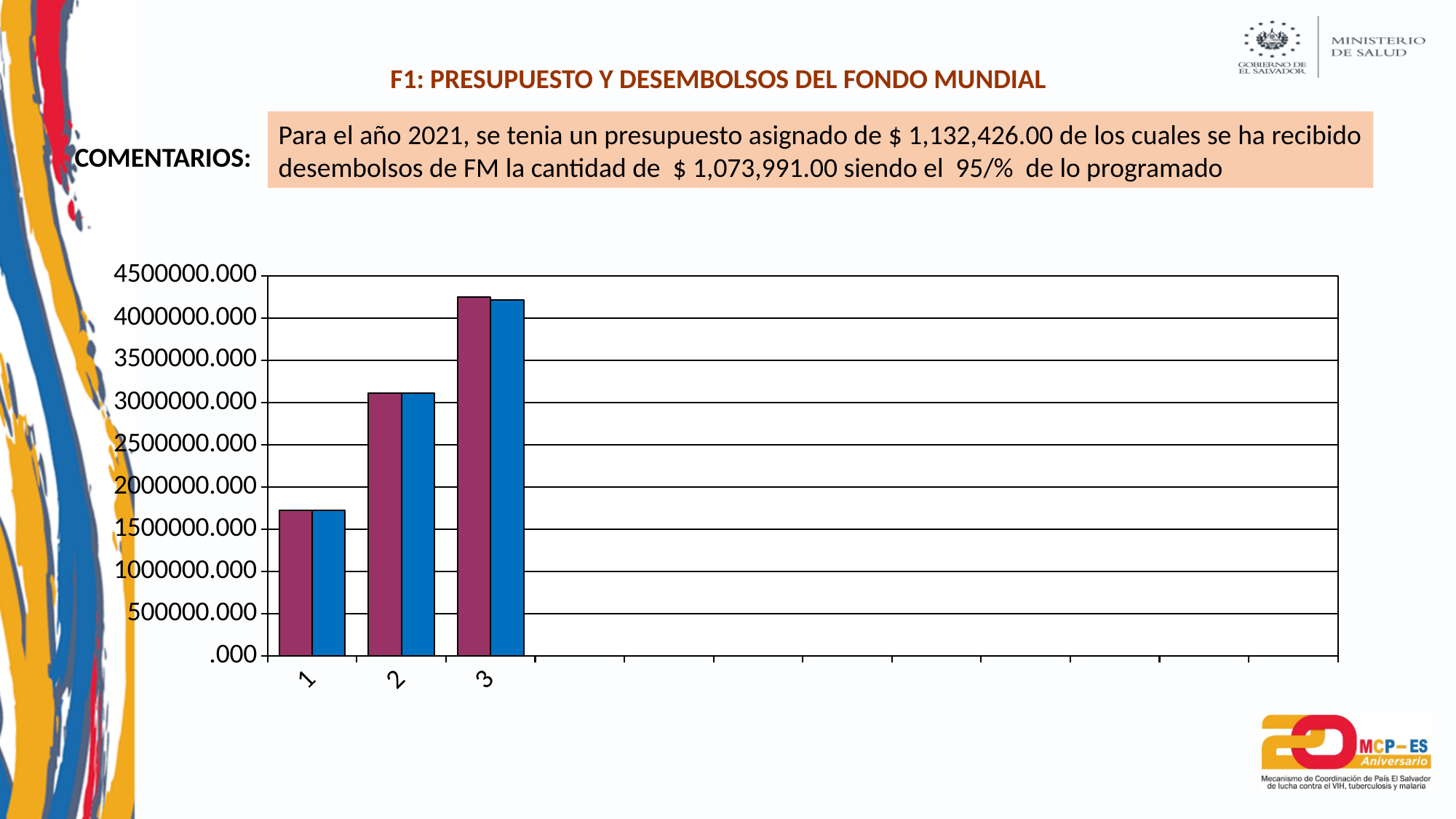
Do the bar values rise or fall from category 1 to category 3? rise What is the highest value shown on the y axis of the chart? 4500000.000 Which category has the shortest bars in the chart? 1 Is the value of the purple bar for category 1 greater or less than 2000000.000? less How many categories are shown on the x axis of the chart? 3 Which is larger, the purple bar for category 2 or the purple bar for category 3? category 3 What kind of chart is shown on the slide? bar chart Is the value of the blue bar for category 2 greater or less than 3000000.000? greater Is the value of the blue bar for category 1 greater or less than 1500000.000? greater Which category has the tallest bars in the chart? 3 How many bars are plotted for each category in the chart? 2